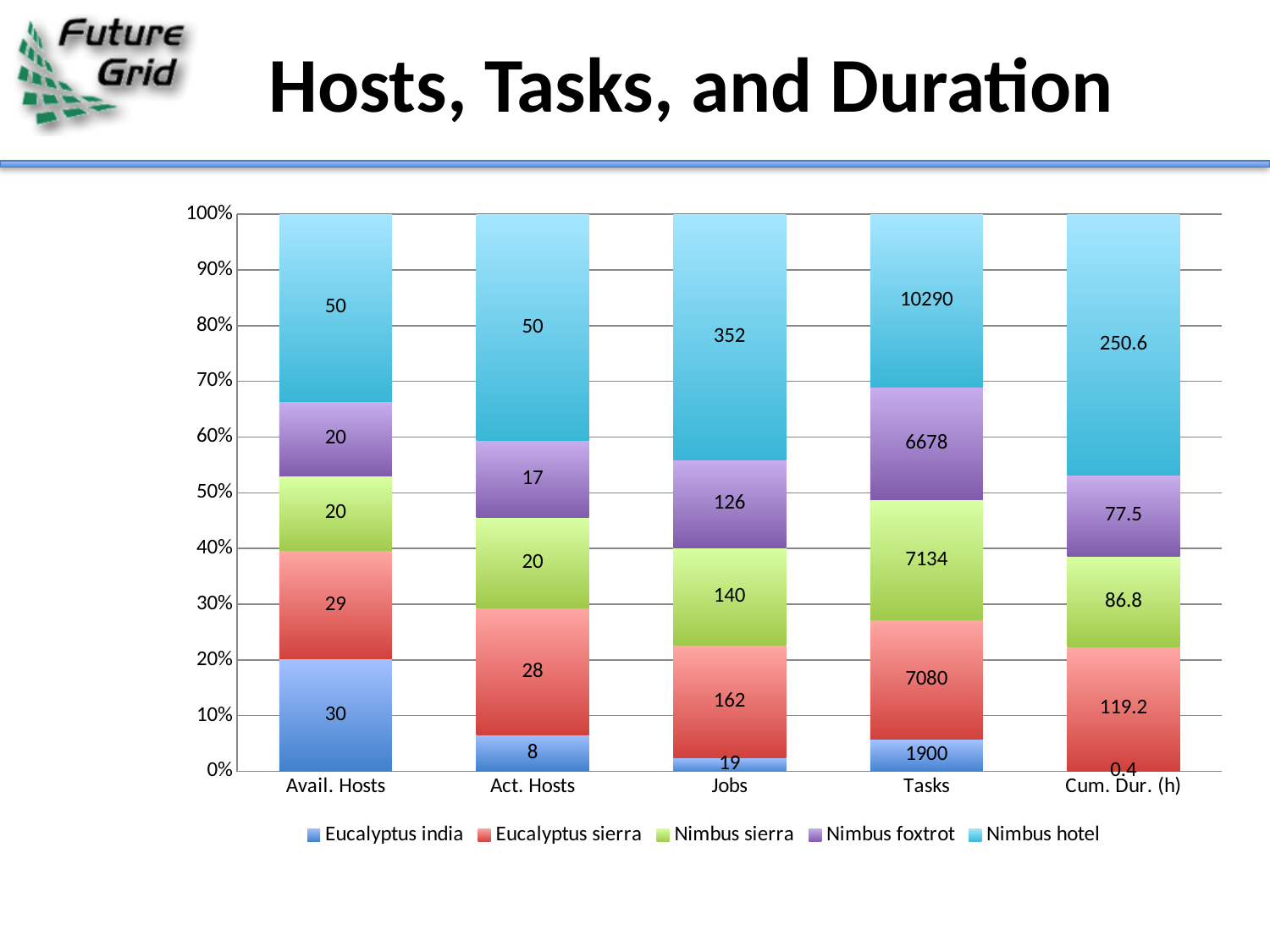
What is the difference between the Nimbus sierra and Nimbus foxtrot values in the Tasks bar? 456 In the Act. Hosts bar, which is larger: Eucalyptus sierra or Nimbus foxtrot? Eucalyptus sierra Which series has the largest value in the Jobs bar? Nimbus hotel What is the value for Eucalyptus india in the Avail. Hosts bar? 30 Which series has the smallest value in the Cum. Dur. (h) bar? Eucalyptus india How many series does the legend list? 5 What kind of chart is shown on the slide? 100% stacked bar chart What is the value for Nimbus hotel in the Tasks bar? 10290 What is the value for Nimbus foxtrot in the Jobs bar? 126 How many categories are shown on the x axis? 5 What is the total of all series in the Act. Hosts bar? 123 What is the value for Eucalyptus sierra in the Cum. Dur. (h) bar? 119.2